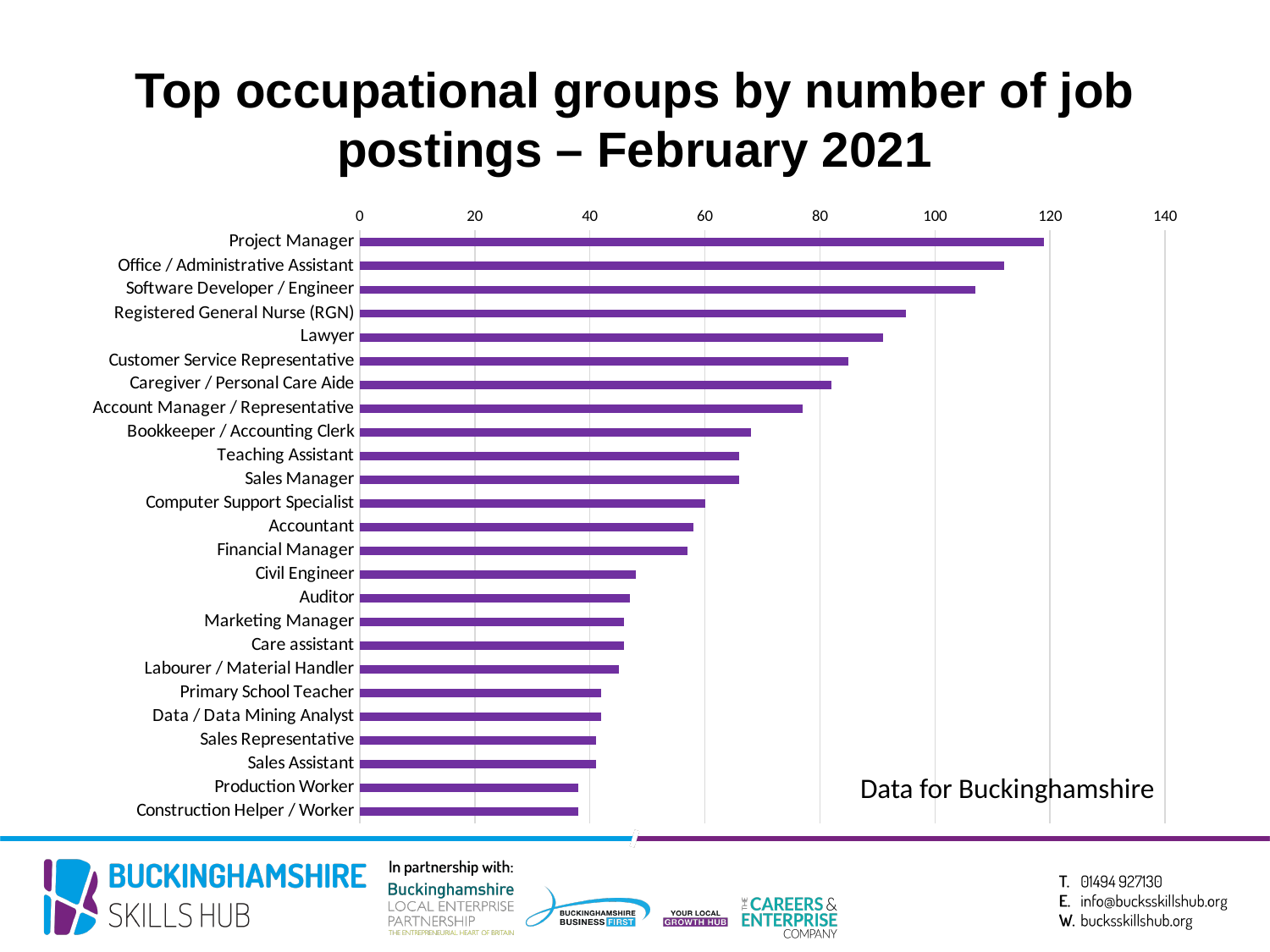
Which occupational group has the highest number of job postings? Project Manager How many occupational groups are listed on the chart? 25 Is the value for Lawyer greater or less than 80? greater Is the value for Registered General Nurse (RGN) greater or less than 100? less Is the value for Project Manager greater or less than 100? greater Which has more job postings, Lawyer or Accountant? Lawyer What kind of chart is shown on the slide? Bar chart What is the title of the chart on the slide? Top occupational groups by number of job postings – February 2021